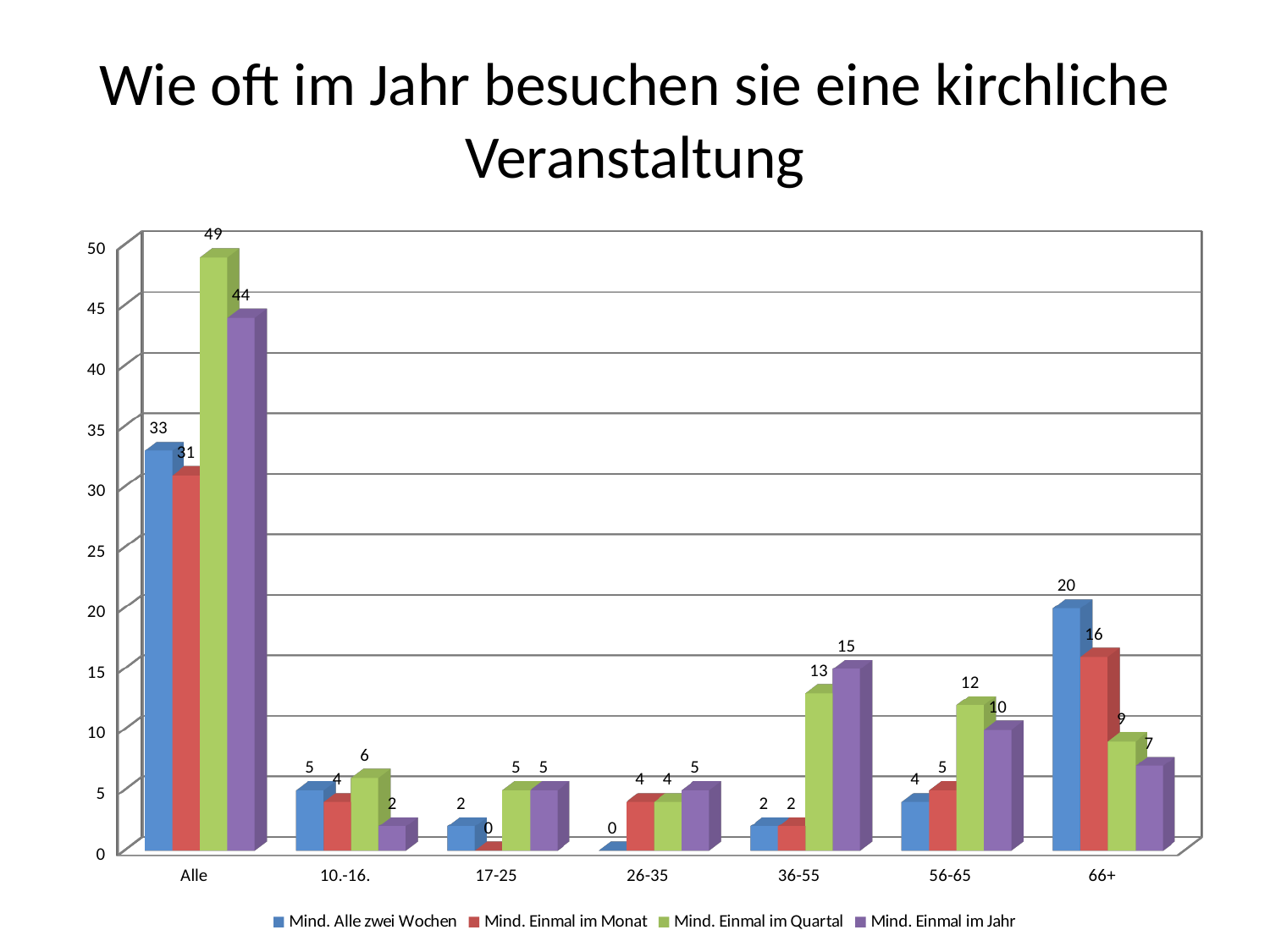
Which age category has the highest value for "Mind. Alle zwei Wochen" (excluding "Alle")? 66+ What is the difference between "Mind. Einmal im Quartal" and "Mind. Einmal im Jahr" in the "Alle" category? 5 What is the value for "Mind. Einmal im Jahr" in the "36-55" category? 15 How many categories are shown on the x axis? 7 In the "56-65" category, which is larger: "Mind. Einmal im Quartal" or "Mind. Einmal im Jahr"? Mind. Einmal im Quartal What is the value for "Mind. Einmal im Quartal" in the "Alle" category? 49 What is the value for "Mind. Einmal im Monat" in the "17-25" category? 0 What kind of chart is shown on the slide? Bar chart Which colour represents the series "Mind. Einmal im Monat"? Red How many series does the legend list? 4 What is the value for "Mind. Alle zwei Wochen" in the "66+" category? 20 Which category has the lowest value for "Mind. Einmal im Jahr"? 10.-16.